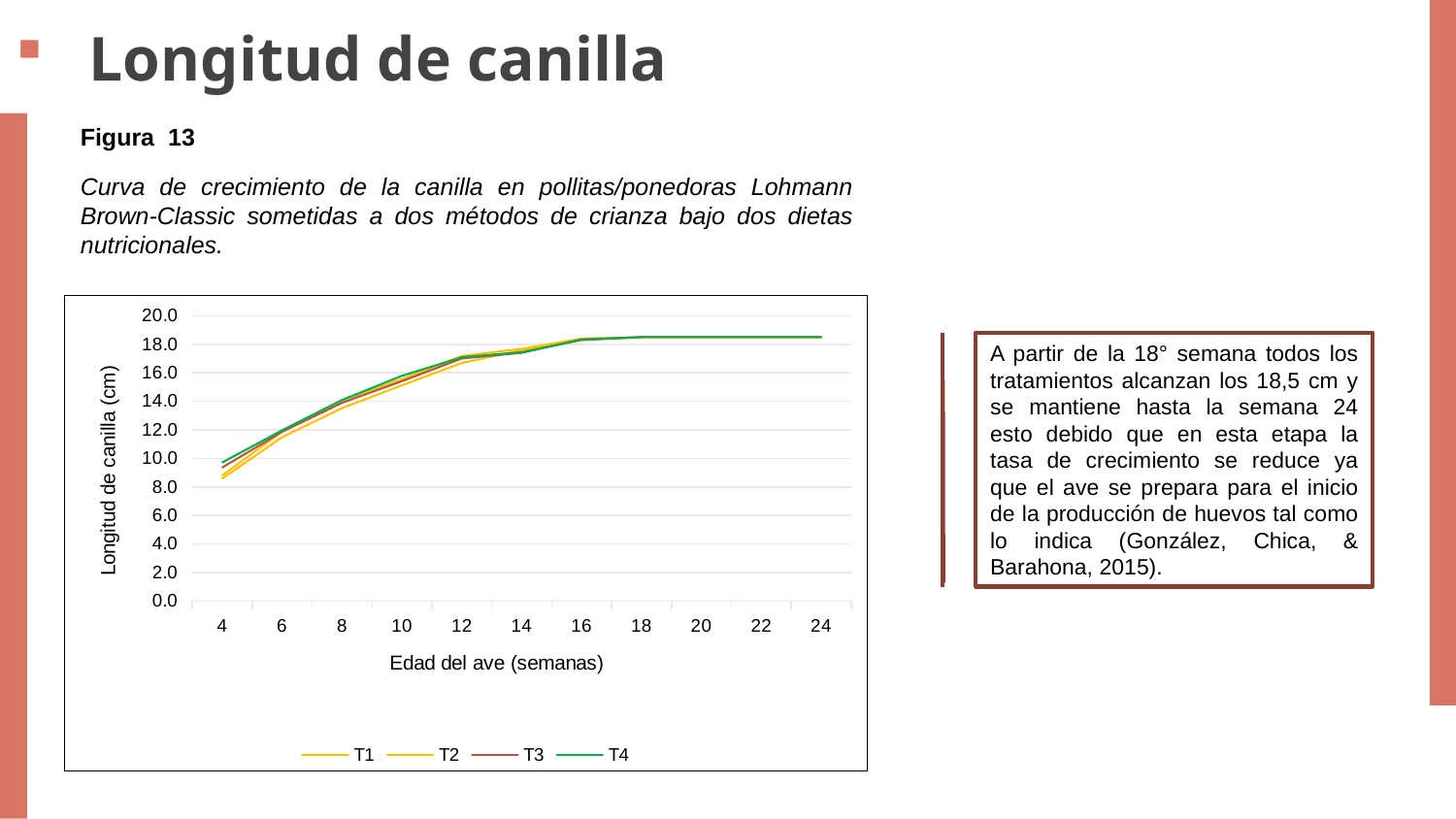
At which age (in weeks) are the values of all series lowest? 4 How many age points (weeks) are marked along the x axis of the chart? 11 For T4, is the value at week 16 larger or smaller than the value at week 6? larger Is the value for T2 at week 8 greater or less than 10.0? greater What are the series names listed in the chart legend? T1, T2, T3, T4 What is the label of the y axis of the chart? Longitud de canilla (cm) What kind of chart is shown on the slide? line chart Is the value for T3 at week 12 greater or less than 14.0? greater How many series does the chart legend list? 4 Do the values in the chart rise or fall as the age of the bird increases from week 4 to week 24? rise Is the value for T1 at week 24 greater or less than 16.0? greater